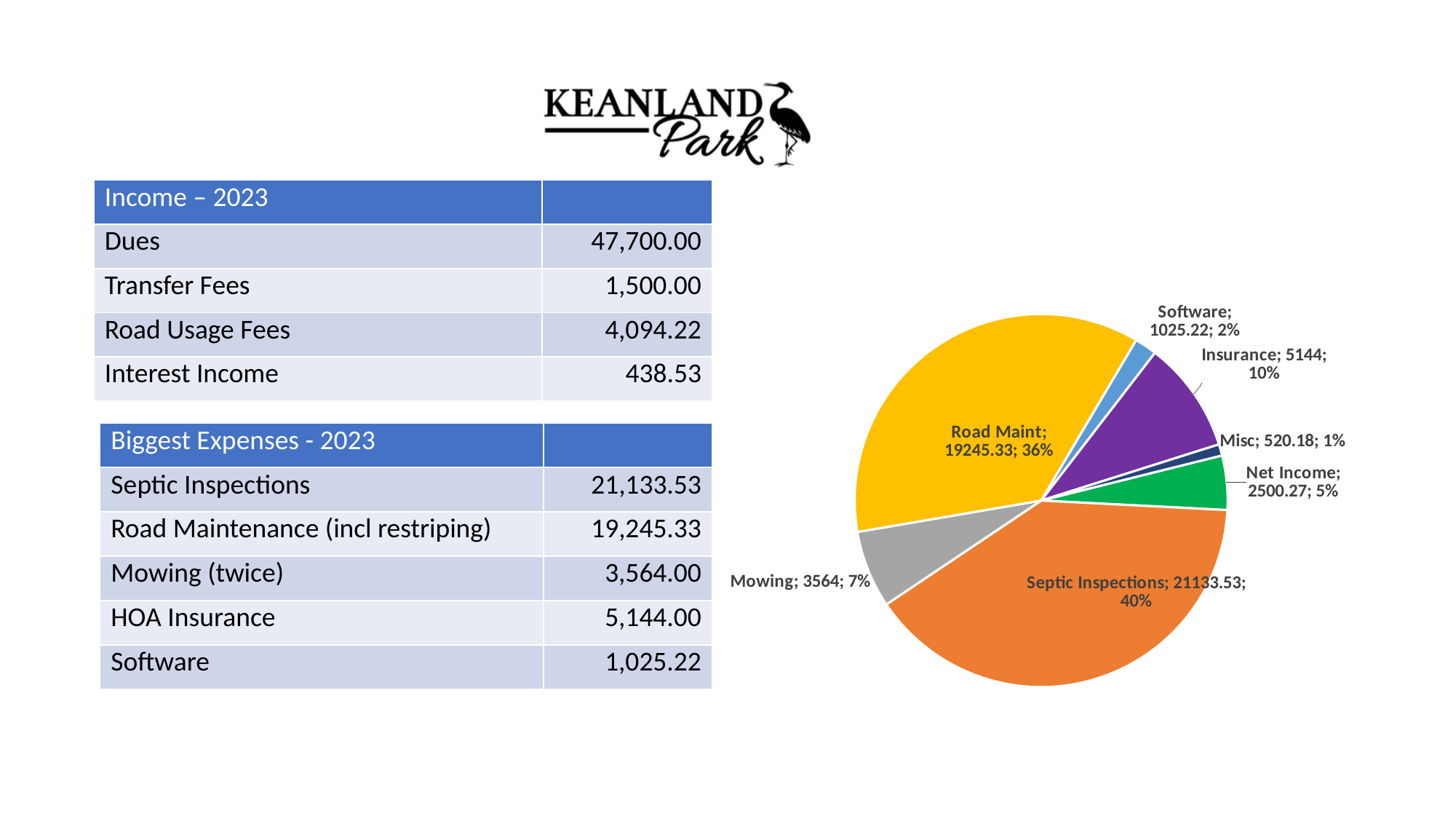
What colour is the Road Maint slice in the pie chart? yellow What share of the pie does Mowing represent? 7% Which is larger in the pie chart, Net Income or Mowing? Mowing What share of the pie does Insurance represent? 10% Which slice of the pie chart is the smallest? Misc What is the difference between the Septic Inspections value and the Road Maint value in the pie chart? 1888.2 What value is shown for Road Maint in the pie chart? 19245.33 Which slice of the pie chart is the largest? Septic Inspections What value is shown for Misc in the pie chart? 520.18 What value is shown for Septic Inspections in the pie chart? 21133.53 How many slices does the pie chart have? 7 What type of chart is shown on the slide? pie chart